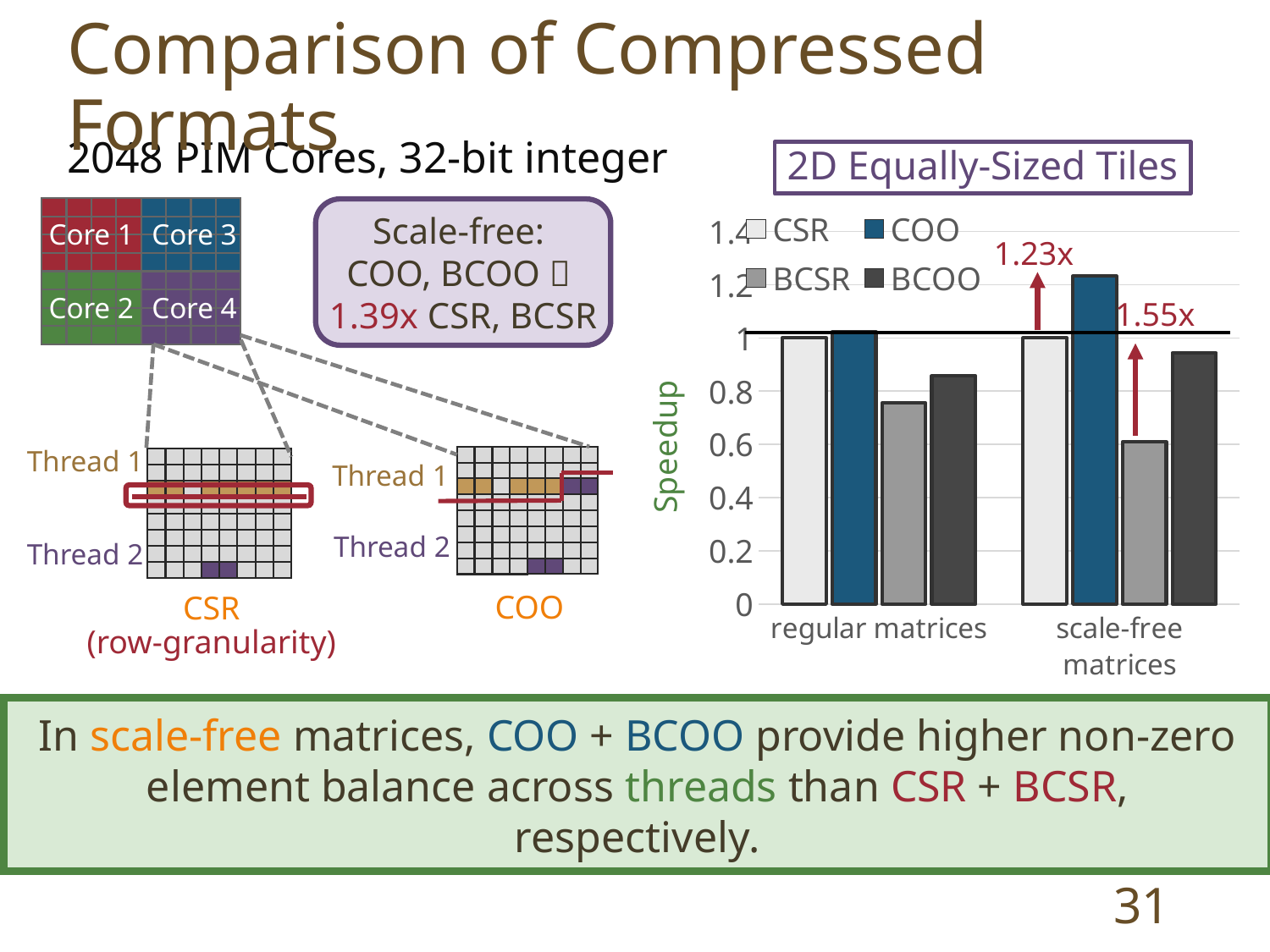
In the "2D Equally-Sized Tiles" chart, is the COO speedup for scale-free matrices greater or less than 1.2? greater How many series does the legend of the "2D Equally-Sized Tiles" chart list? 4 In the "2D Equally-Sized Tiles" chart, is the COO speedup larger for regular matrices or for scale-free matrices? scale-free matrices In the "2D Equally-Sized Tiles" chart, is the BCOO speedup for regular matrices greater or less than 0.8? greater In the "2D Equally-Sized Tiles" chart, is the BCSR speedup for scale-free matrices greater or less than 0.8? less How many categories are shown on the x axis of the "2D Equally-Sized Tiles" chart? 2 What kind of chart is shown under the title "2D Equally-Sized Tiles"? bar chart In the "2D Equally-Sized Tiles" chart, is the BCSR speedup larger for regular matrices or for scale-free matrices? regular matrices In the "2D Equally-Sized Tiles" chart, which series has the lowest speedup for regular matrices? BCSR In the "2D Equally-Sized Tiles" chart, which series has the lowest speedup for scale-free matrices? BCSR What is the label of the y axis in the "2D Equally-Sized Tiles" chart? Speedup In the "2D Equally-Sized Tiles" chart, which series has the highest speedup for scale-free matrices? COO